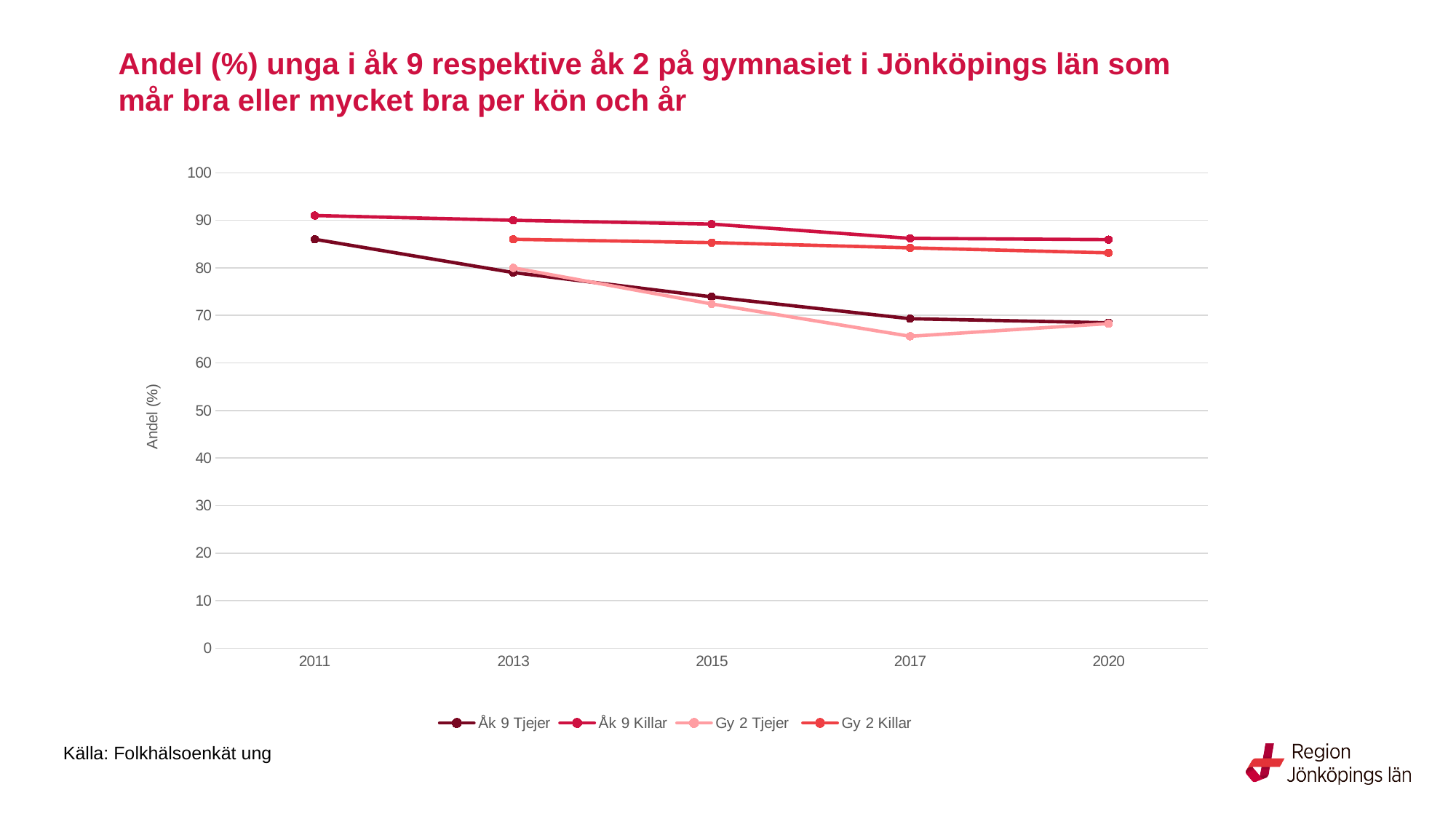
Is the value for Gy 2 Tjejer in 2017 greater or less than 70? less Is the value for Gy 2 Killar in 2013 greater or less than 80? greater Which series has the lowest value in 2017? Gy 2 Tjejer How many data points does the Gy 2 Killar line have? 4 What is the label on the y axis? Andel (%) Which series has the highest value in 2020? Åk 9 Killar How many years are shown on the x axis? 5 What kind of chart is shown on the slide? line chart Does the Åk 9 Killar line rise or fall from 2011 to 2020? fall In 2017, which is higher: Åk 9 Tjejer or Gy 2 Tjejer? Åk 9 Tjejer Is the value for Åk 9 Tjejer in 2011 greater or less than 80? greater How many series does the legend list? 4